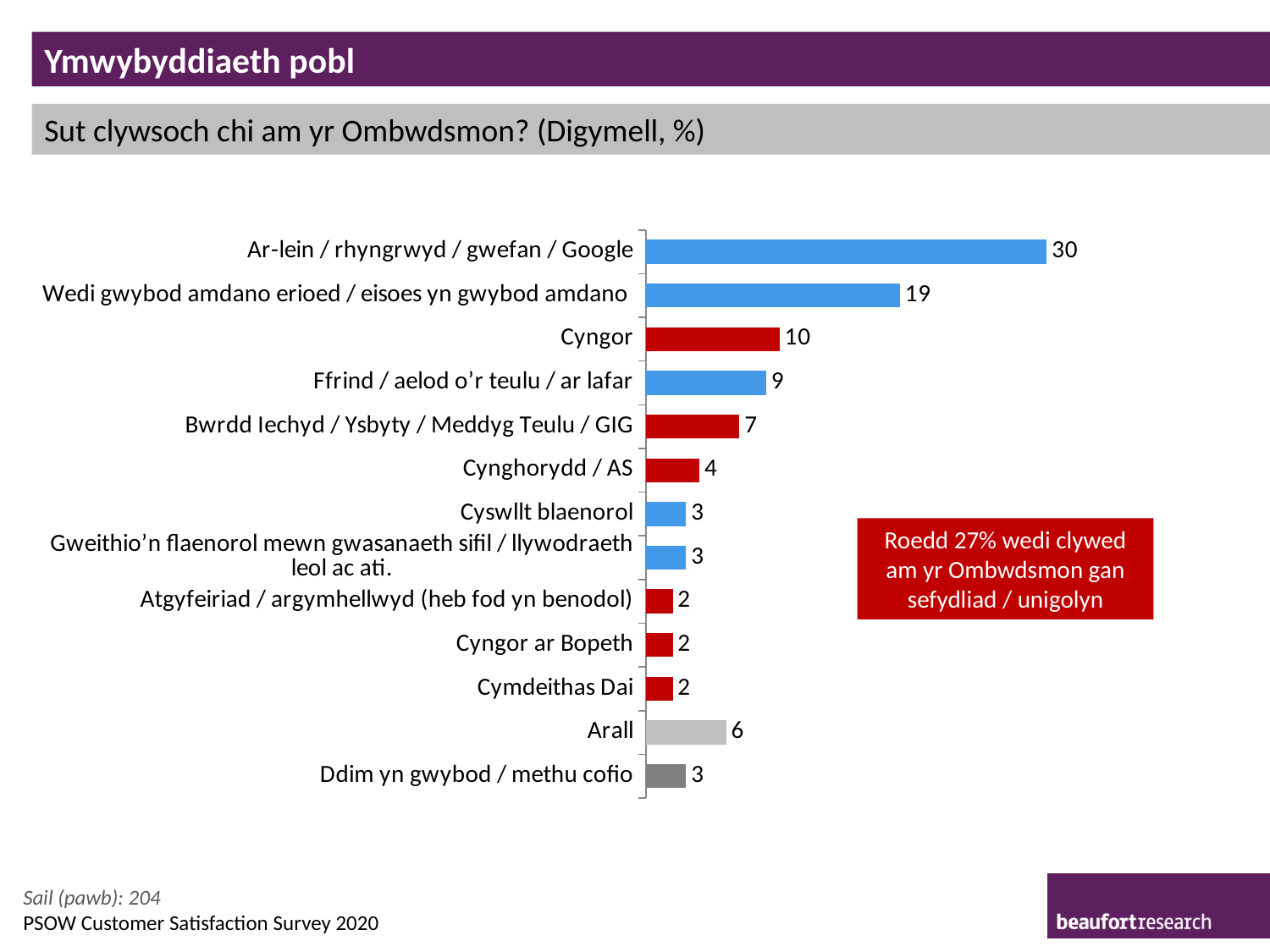
What is the value for "Cynghorydd / AS"? 4 What is the value for "Ar-lein / rhyngrwyd / gwefan / Google"? 30 What is the value for "Cyngor"? 10 According to the red text box on the slide, what percentage had heard about the Ombudsman from an organisation or individual? 27% Which is larger, the value for "Cyngor" or the value for "Ffrind / aelod o'r teulu / ar lafar"? Cyngor What kind of chart is shown on the slide? Bar chart What is the value for "Bwrdd Iechyd / Ysbyty / Meddyg Teulu / GIG"? 7 What is the difference between the values for "Ar-lein / rhyngrwyd / gwefan / Google" and "Wedi gwybod amdano erioed / eisoes yn gwybod amdano"? 11 What is the value for "Arall"? 6 Which category has the highest value? Ar-lein / rhyngrwyd / gwefan / Google What is the value for "Ddim yn gwybod / methu cofio"? 3 How many categories are shown in the chart? 13